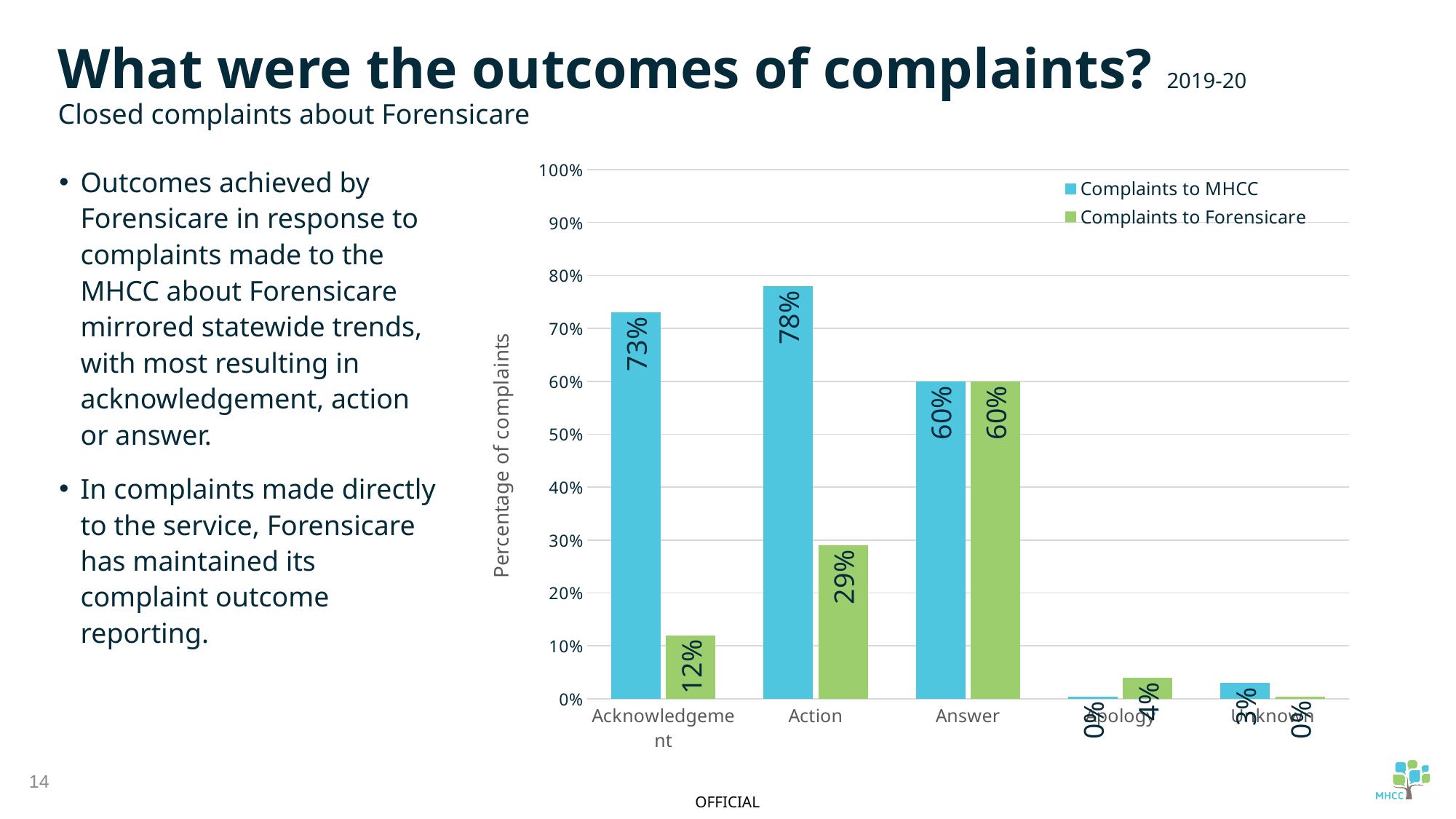
How many series does the legend list? 2 What kind of chart is shown on the slide? bar chart What percentage of complaints to Forensicare resulted in Apology? 4% What percentage of complaints to MHCC resulted in Acknowledgement? 73% What is the difference between Complaints to MHCC and Complaints to Forensicare for Action? 49% For Acknowledgement, which series has the larger value: Complaints to MHCC or Complaints to Forensicare? Complaints to MHCC Which outcome category has the lowest value for Complaints to Forensicare? Unknown How many outcome categories are shown on the x axis? 5 What is the label of the y axis? Percentage of complaints What percentage of complaints to Forensicare resulted in Answer? 60% Which outcome category has the highest value for Complaints to MHCC? Action What percentage of complaints to Forensicare resulted in Action? 29%